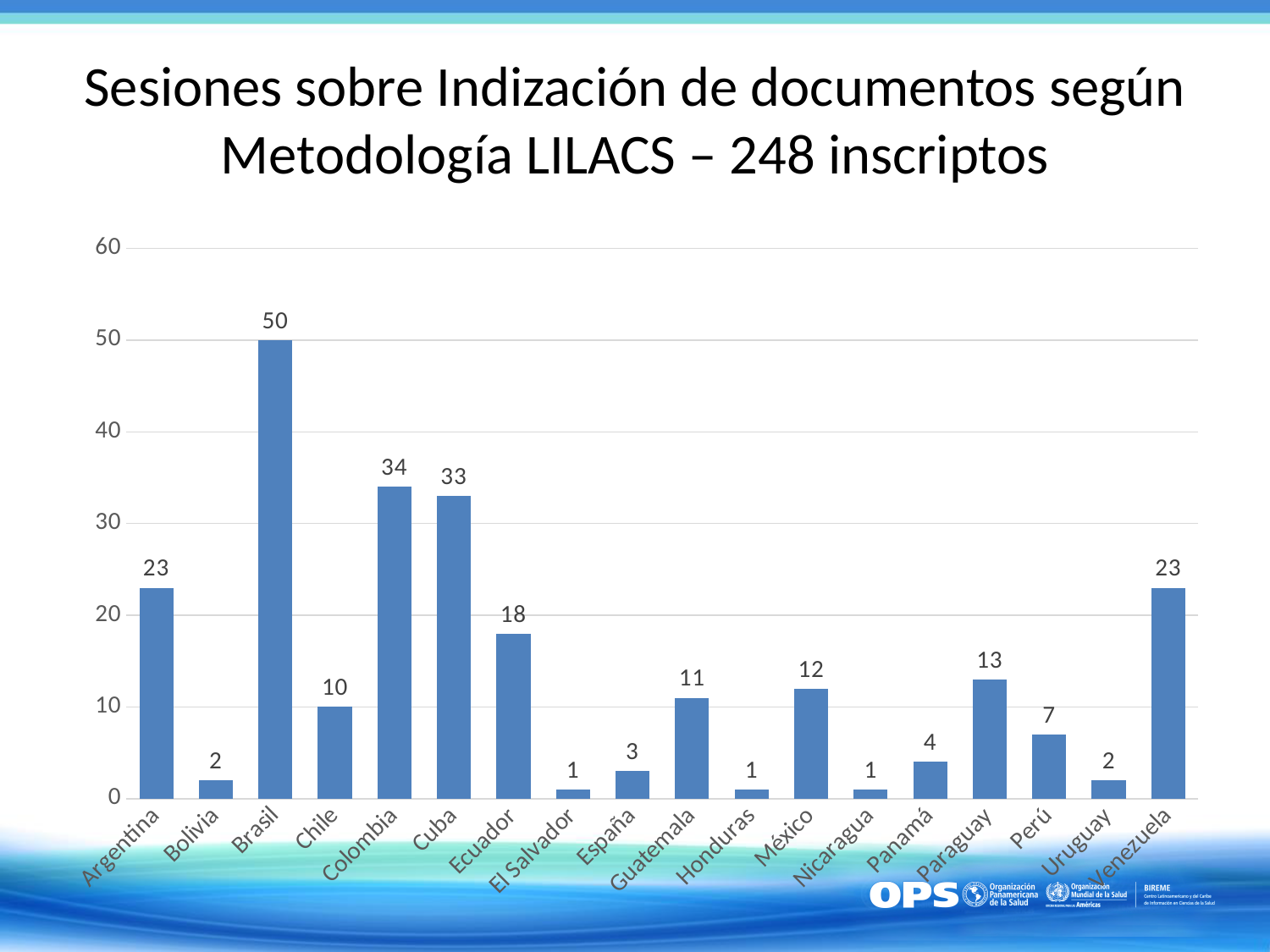
What is the difference between the values for Argentina and Chile? 13 What is the value for Brasil? 50 What is the value for Paraguay? 13 Which country has the highest value? Brasil What is the title of the slide? Sesiones sobre Indización de documentos según Metodología LILACS – 248 inscriptos What kind of chart is shown on the slide? Bar chart What is the difference between the values for Brasil and Colombia? 16 Which is larger, the value for Colombia or the value for Cuba? Colombia What is the value for Venezuela? 23 Which is larger, the value for México or the value for Guatemala? México How many countries are shown on the x axis? 18 What is the value for Ecuador? 18